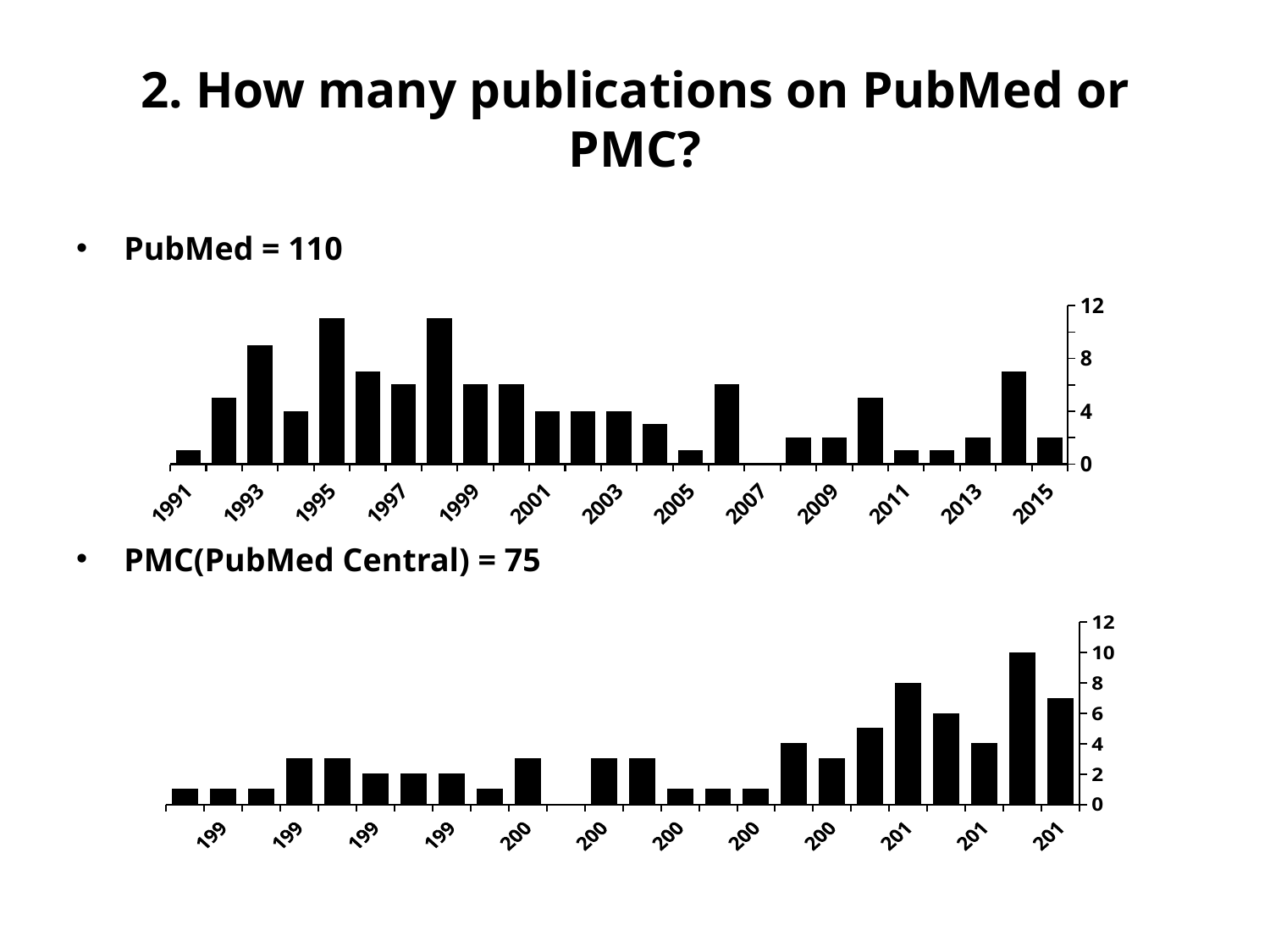
What kind of chart is the top chart (PubMed)? bar chart In the top chart (PubMed), which year is larger, 1995 or 2005? 1995 In the top chart (PubMed), is the value for 2005 greater or less than 4? less In the bottom chart (PMC), what value does the tallest bar reach? 10 In the top chart (PubMed), do the values rise or fall from 1991 to 1993? rise In the top chart (PubMed), which labelled year has no bar at all? 2007 In the bottom chart (PMC), do the values generally rise or fall from the left side to the right side of the x axis? rise What is the highest value shown on the y axis of the bottom chart (PMC)? 12 In the top chart (PubMed), is the value for 2011 greater or less than 4? less In the top chart (PubMed), is the value for 2014 greater or less than 4? greater In the top chart (PubMed), which year is larger, 2013 or 2014? 2014